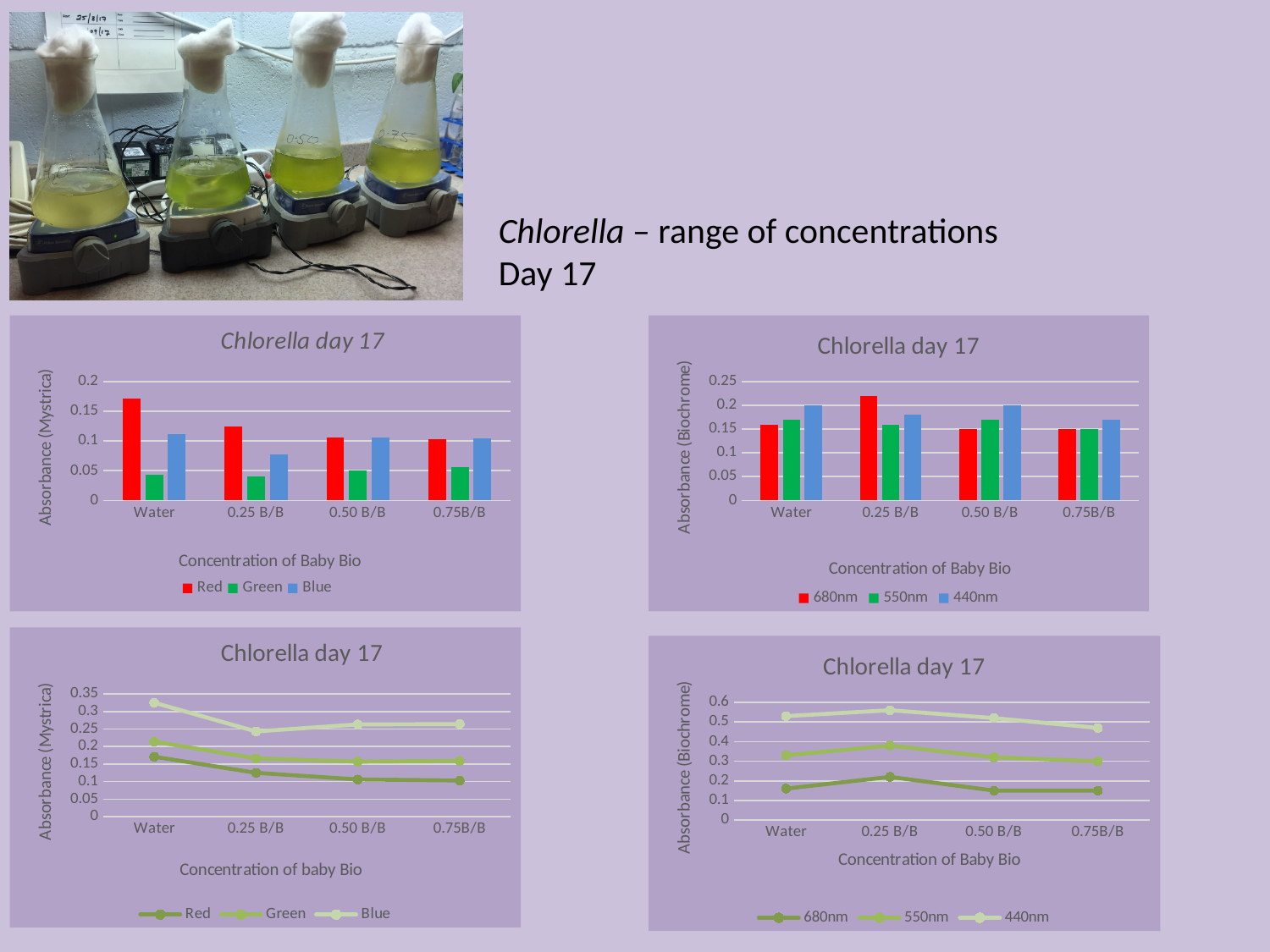
In the bottom-right line chart, which is larger for the 680nm series: the value at 0.25 B/B or at 0.50 B/B? 0.25 B/B In the top-right bar chart, is the 680nm value for 0.25 B/B greater or less than 0.2? greater In the top-left bar chart, how many concentration categories are shown on the x axis? 4 In the top-left bar chart, is the Red value for Water greater or less than 0.15? greater What kind of chart is the bottom-left chart on the slide? line chart In the top-left bar chart, which concentration has the highest Red bar? Water In the top-right bar chart, which series has the tallest bar at Water? 440nm What kind of chart is the top-left chart on the slide? bar chart In the top-right bar chart, how many series does the legend list? 3 In the top-left bar chart, is the Red value for 0.25 B/B greater or less than 0.1? greater